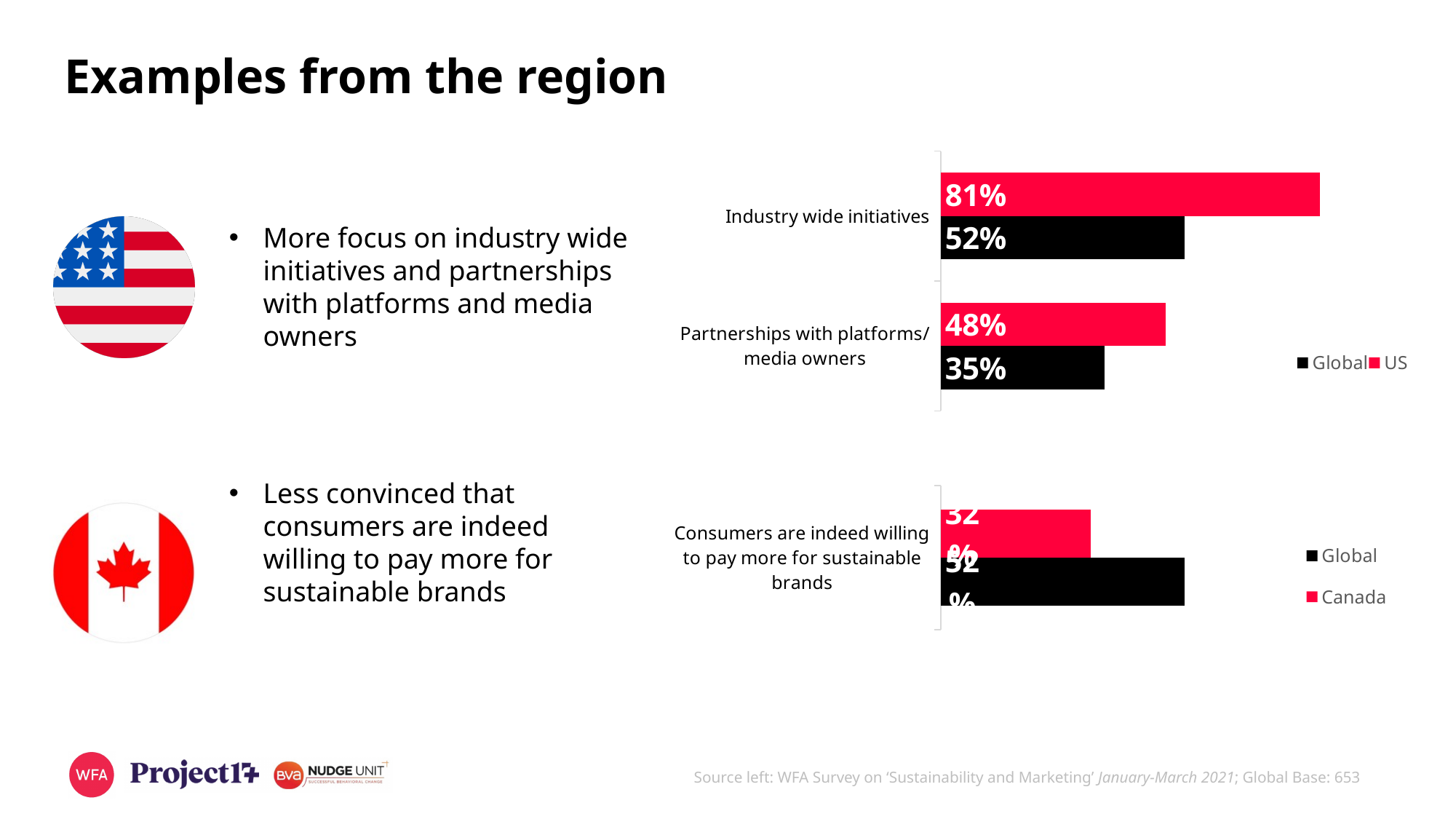
In the bottom chart, is the Global or the Canada bar longer for 'Consumers are indeed willing to pay more for sustainable brands'? Global In the top chart, is the US or the Global value larger for Partnerships with platforms/media owners? US In the top chart, what is the difference between the US and Global values for Partnerships with platforms/media owners? 13% How many series does the legend of the top chart list? 2 In the top chart, what is the US value for Industry wide initiatives? 81% In the top chart, what is the difference between the US and Global values for Industry wide initiatives? 29% In the top chart, what is the Global value for Partnerships with platforms/media owners? 35% What type of chart is the bottom chart? Bar chart In the top chart, what is the US value for Partnerships with platforms/media owners? 48% How many categories are shown in the top chart? 2 In the top chart, which category has the highest US value? Industry wide initiatives In the top chart, what is the Global value for Industry wide initiatives? 52%